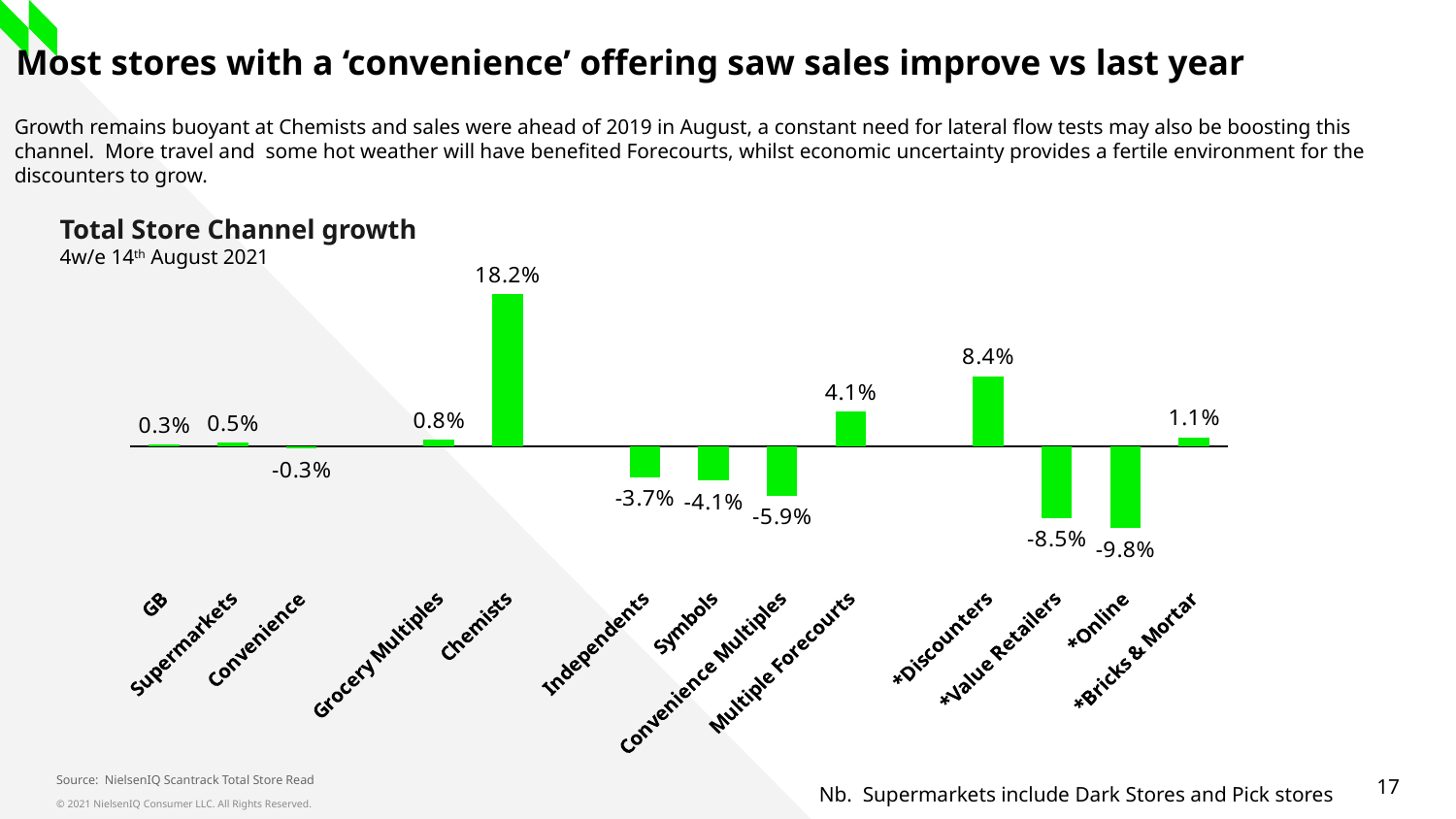
Which category has the lowest value in the Total Store Channel growth chart? *Online What is the value for Multiple Forecourts in the Total Store Channel growth chart? 4.1% What is the value for *Online in the Total Store Channel growth chart? -9.8% What is the difference between the values for Chemists and *Discounters in the Total Store Channel growth chart? 9.8% Which category has the highest value in the Total Store Channel growth chart? Chemists What is the value for Convenience in the Total Store Channel growth chart? -0.3% How many categories are shown in the Total Store Channel growth chart? 13 Which is larger in the Total Store Channel growth chart, the value for *Discounters or the value for Multiple Forecourts? *Discounters Which is larger in the Total Store Channel growth chart, the value for Supermarkets or the value for Grocery Multiples? Grocery Multiples What is the value for Chemists in the Total Store Channel growth chart? 18.2% What kind of chart is the Total Store Channel growth chart? Bar chart What period does the subtitle of the Total Store Channel growth chart refer to? 4w/e 14th August 2021